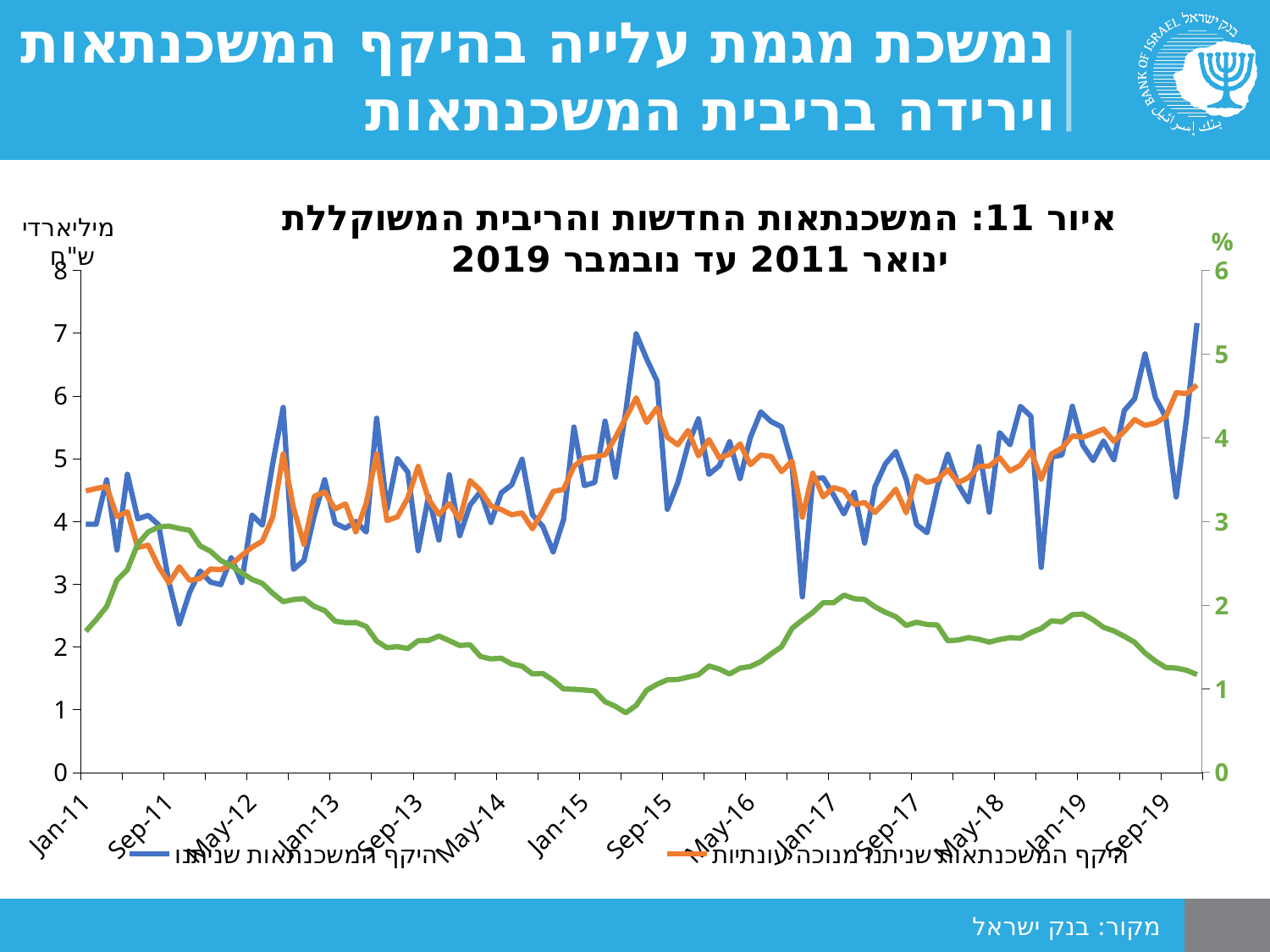
What is the title of the chart? איור 11: המשכנתאות החדשות והריבית המשוקללת ינואר 2011 עד נובמבר 2019 Does the green line generally rise or fall between Jan-11 and Sep-15? fall Is the value of the orange line at Sep-19 greater or less than 4 on the left axis? greater Which line is higher at Sep-15, the blue line or the orange line? orange line Is the value of the green line at Jan-11 greater or less than 2 on the right axis? less Is the peak of the blue line around Sep-15 greater or less than 6 on the left axis? greater What unit is shown on the left vertical axis of the chart? מיליארדי ש"ח What kind of chart is shown on the slide? line chart Does the orange line generally rise or fall between Jan-17 and Sep-19? rise How many lines are plotted on the chart? 3